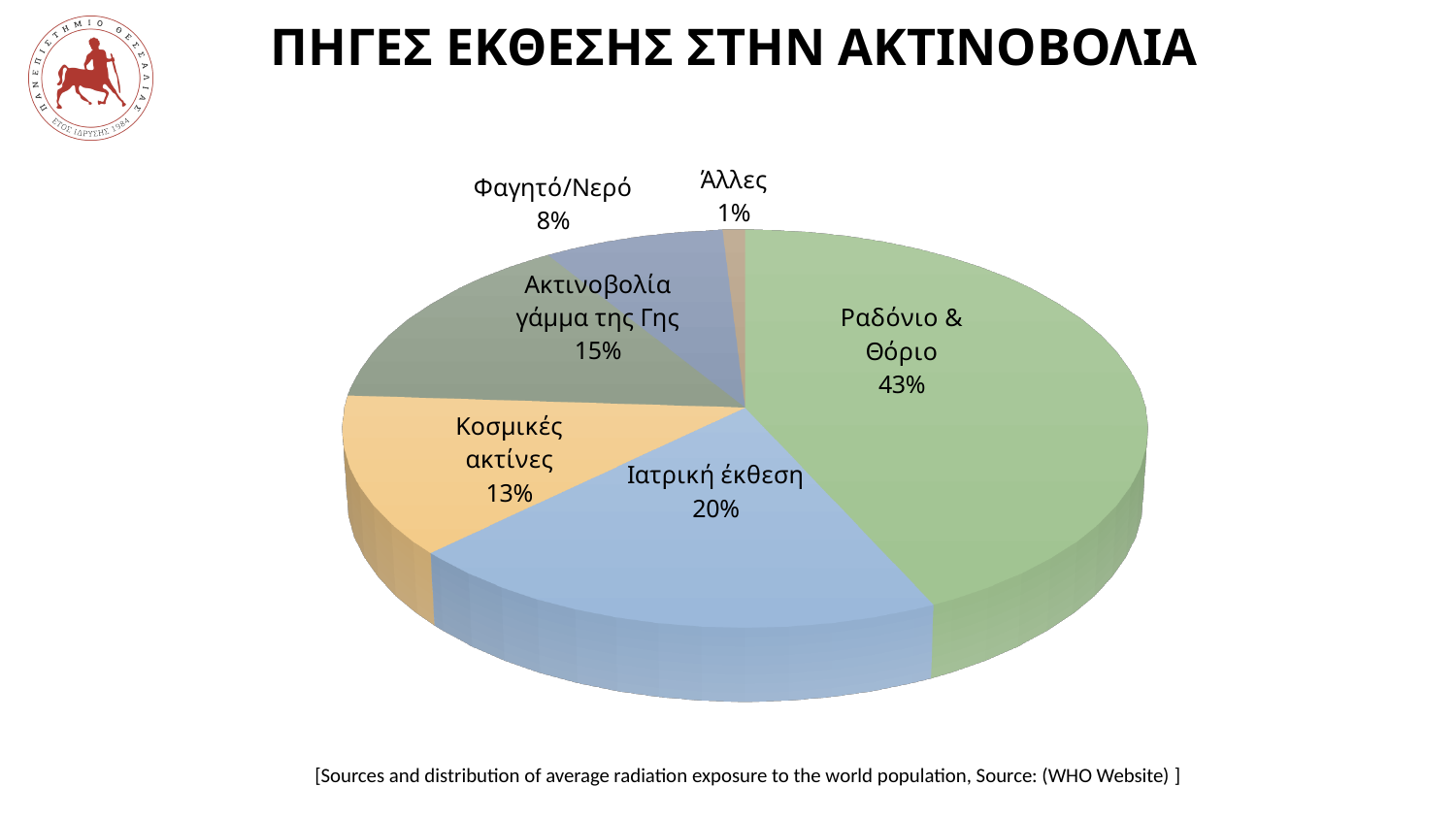
What is the value for Κοσμικές ακτίνες? 13% Which is larger, Ακτινοβολία γάμμα της Γης or Κοσμικές ακτίνες? Ακτινοβολία γάμμα της Γης What percentage is shown for Ιατρική έκθεση? 20% What share of radiation exposure comes from Ραδόνιο & Θόριο? 43% What is the difference in percentage points between Ραδόνιο & Θόριο and Ιατρική έκθεση? 23 Which source has the largest share of the pie? Ραδόνιο & Θόριο Which source has the smallest share of the pie? Άλλες What is the title of the slide containing the chart? ΠΗΓΕΣ ΕΚΘΕΣΗΣ ΣΤΗΝ ΑΚΤΙΝΟΒΟΛΙΑ What type of chart is shown on the slide? Pie chart What share does Φαγητό/Νερό account for? 8% What percentage is labelled for Ακτινοβολία γάμμα της Γης? 15% How many slices does the pie chart have? 6